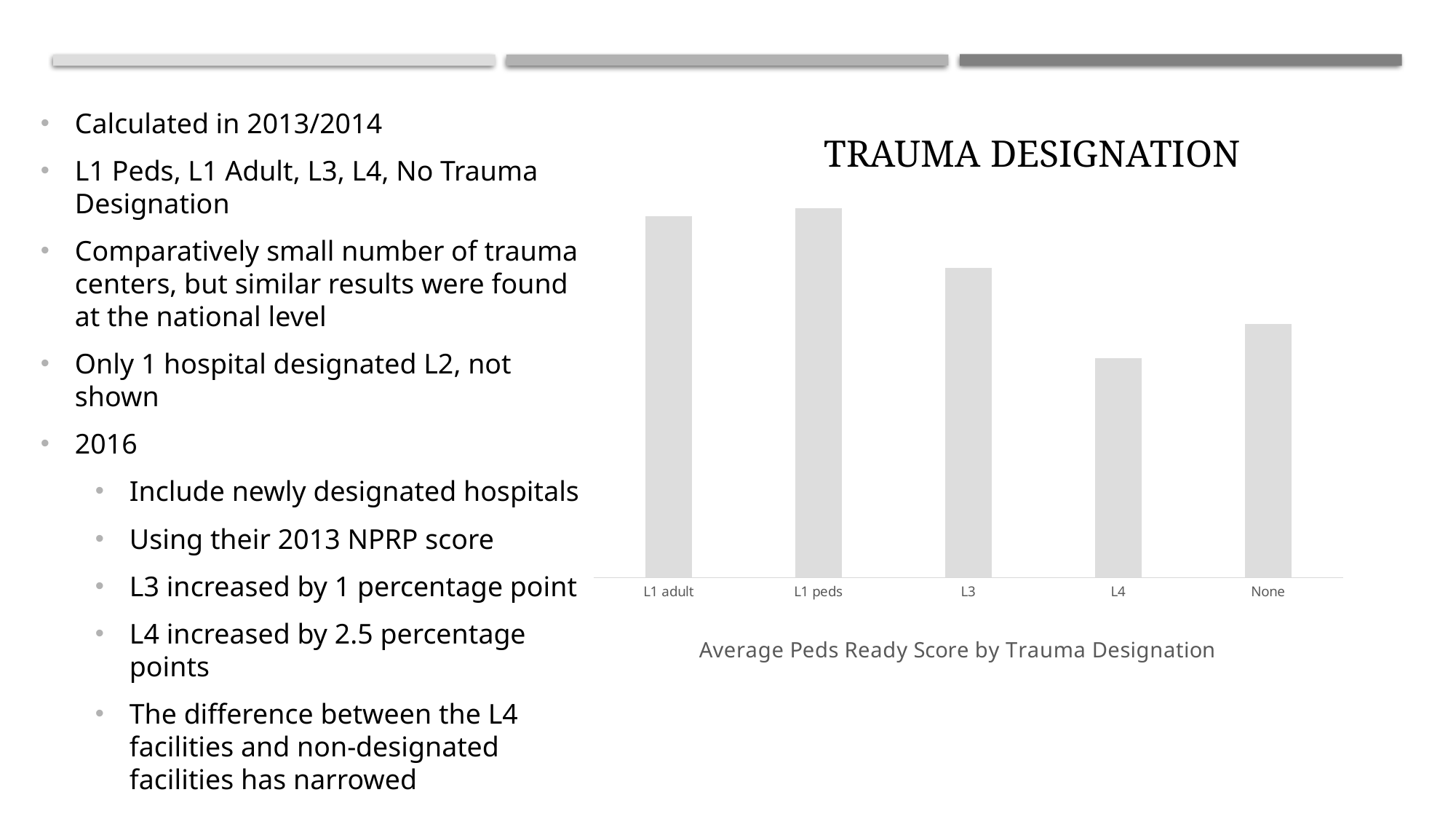
Which is larger in the chart, the value for L4 or the value for None? None How many trauma designation categories are plotted in the chart? 5 What caption appears below the chart? Average Peds Ready Score by Trauma Designation What kind of chart is shown on the slide? bar chart What is the title of the chart? TRAUMA DESIGNATION Which trauma designation has the lowest average Peds Ready score in the chart? L4 Which is larger in the chart, the value for L3 or the value for None? L3 Which is larger in the chart, the value for L1 adult or the value for L3? L1 adult Do the values in the chart rise or fall from L1 peds to L4? fall